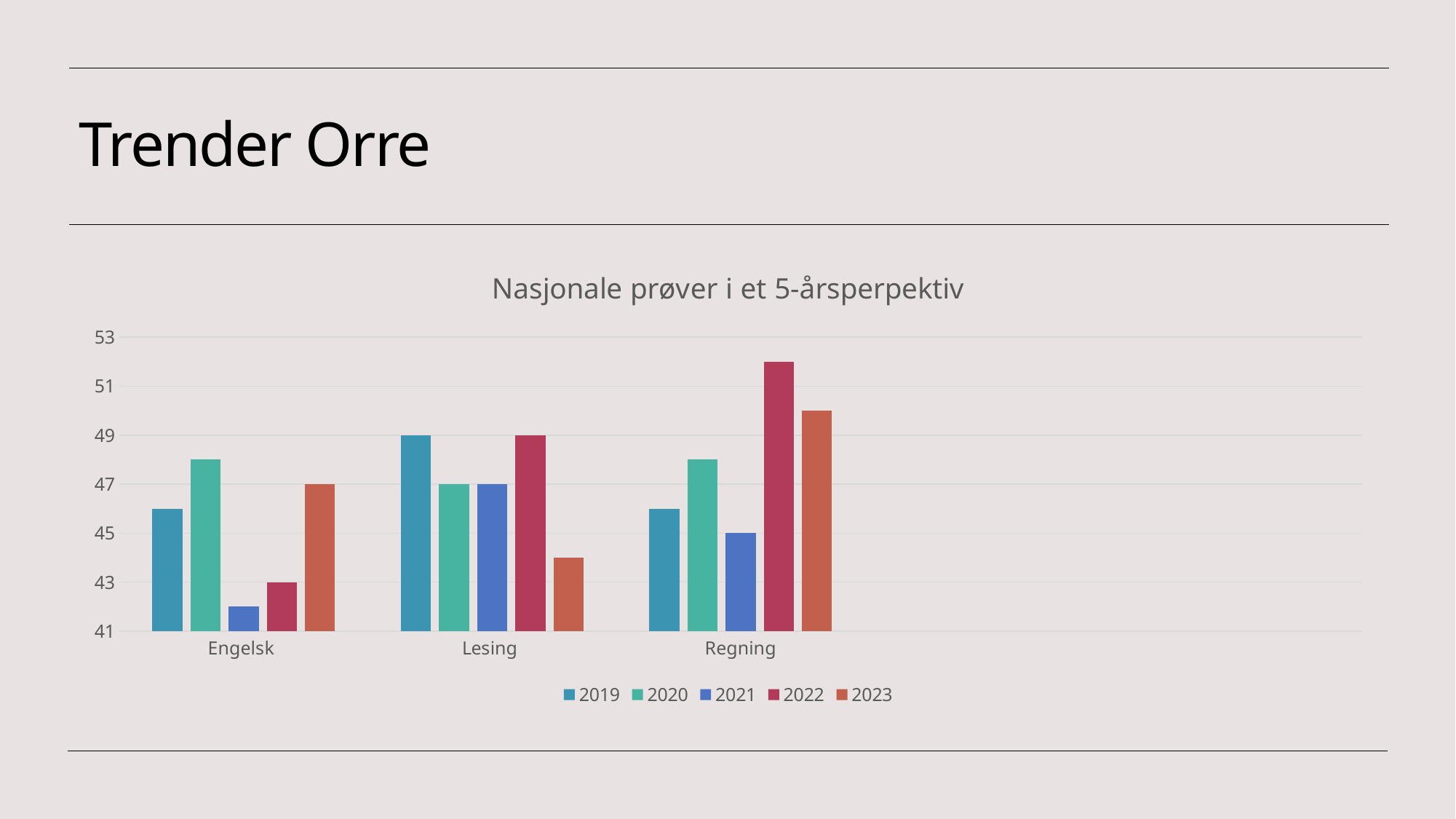
Is the value for 2023 in Lesing greater or less than 45? less What is the value for 2019 in Lesing? 49 What is the value for 2021 in Regning? 45 How many categories are shown on the x axis? 3 Which category has the highest value for 2022? Regning What kind of chart is shown on the slide? bar chart How many series does the legend list? 5 What is the value for 2023 in Engelsk? 47 Which is larger in Lesing, the value for 2019 or the value for 2023? 2019 What is the value for 2022 in Engelsk? 43 Is the value for 2022 in Regning greater or less than 51? greater Which year has the lowest value in Engelsk? 2021